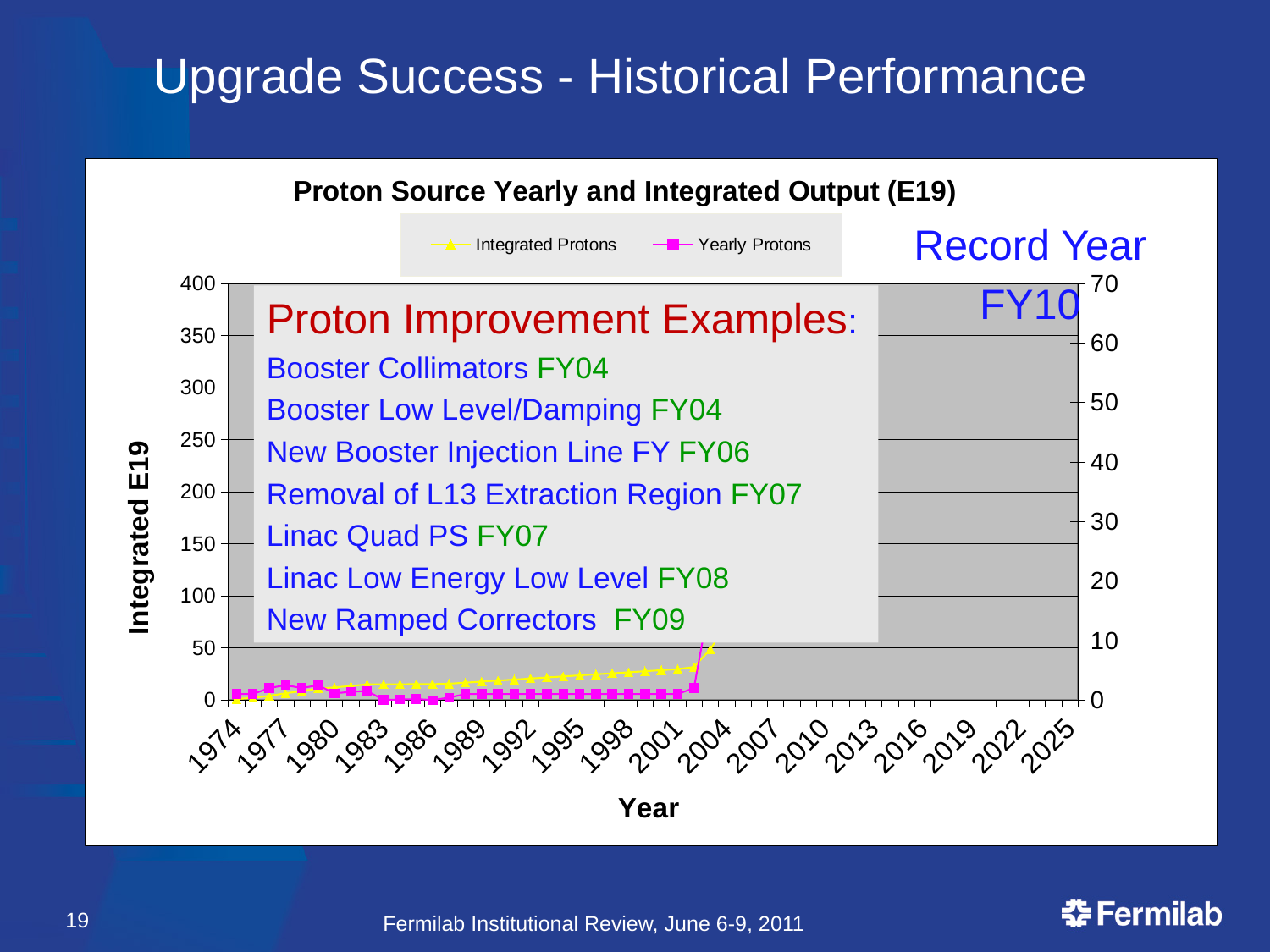
How many year labels are shown along the x axis? 18 Is the Yearly Protons value for 1986 greater or less than 10 on the right axis? less Does the Integrated Protons series rise or fall from 1974 to 2003? rise How many series does the legend list? 2 Is the Integrated Protons value for 2001 greater or less than 50 on the left axis? less What are the two series named in the legend? Integrated Protons and Yearly Protons What kind of chart is shown on the slide? line chart Which series is plotted with yellow triangle markers? Integrated Protons Which series is plotted with magenta square markers? Yearly Protons Is the Integrated Protons value for 1995 greater or less than 100 on the left axis? less What is the first year label on the x axis? 1974